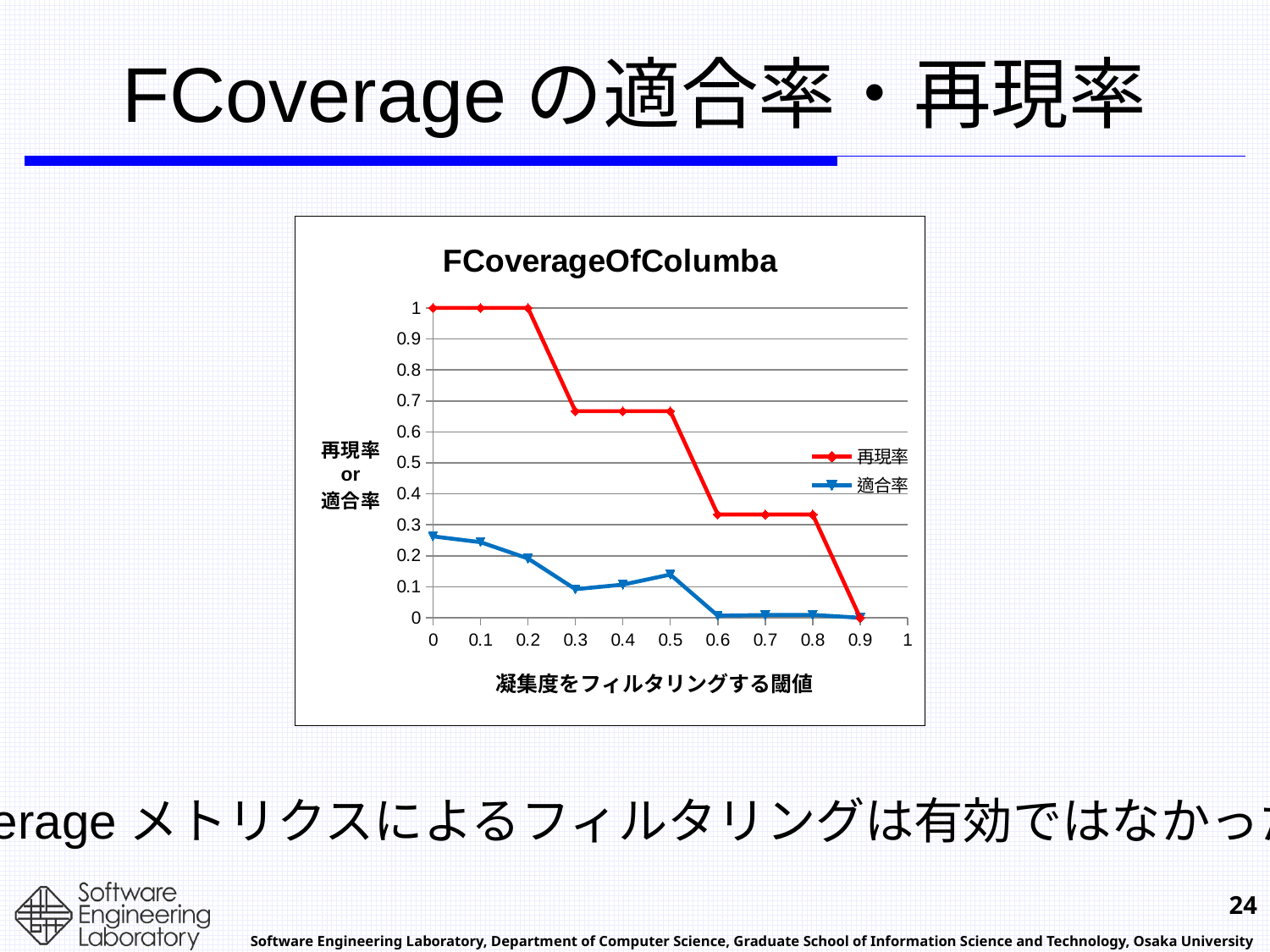
Is the value of 適合率 at threshold 0.3 greater or less than 0.2? less What is the value of 再現率 at threshold 0.9? 0 Does the 再現率 series rise or fall as the threshold increases from 0 to 0.9? fall Is the value of 再現率 at threshold 0.4 greater or less than 0.6? greater How many series does the legend list? 2 Is the value of 再現率 at threshold 0.7 greater or less than 0.5? less What kind of chart is shown on the slide? line chart Which series has the larger value at threshold 0.5, 再現率 or 適合率? 再現率 What is the value of 再現率 at threshold 0.2? 1 What is the label of the x axis? 凝集度をフィルタリングする閾値 What is the title of the chart? FCoverageOfColumba What is the value of 再現率 at threshold 0? 1